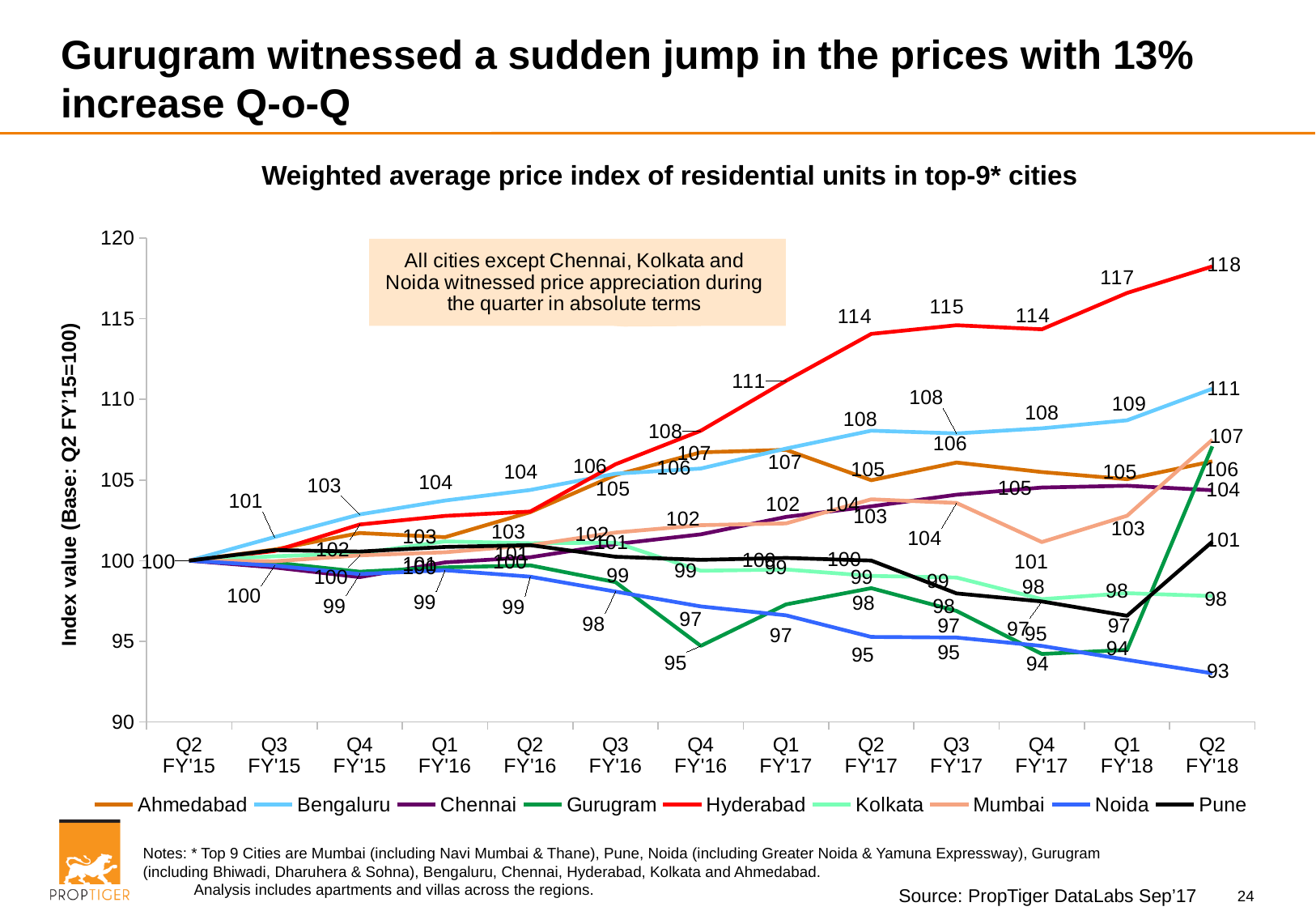
Which city has the lowest index value in Q2 FY'18? Noida What is the difference between the Hyderabad and Bengaluru index values in Q2 FY'18? 7 How many quarters are shown along the x axis? 13 What is the index value for Noida in Q2 FY'18? 93 What type of chart is shown on the slide? Line chart Does the Hyderabad index value generally rise or fall from Q2 FY'15 to Q2 FY'18? Rise What is the index value for Hyderabad in Q2 FY'18? 118 Which city has the highest index value in Q2 FY'18? Hyderabad How many cities (series) does the legend list? 9 What is the title of the chart? Weighted average price index of residential units in top-9* cities What is the index value for Bengaluru in Q2 FY'18? 111 Is the Hyderabad index value in Q2 FY'18 greater or less than 115? greater